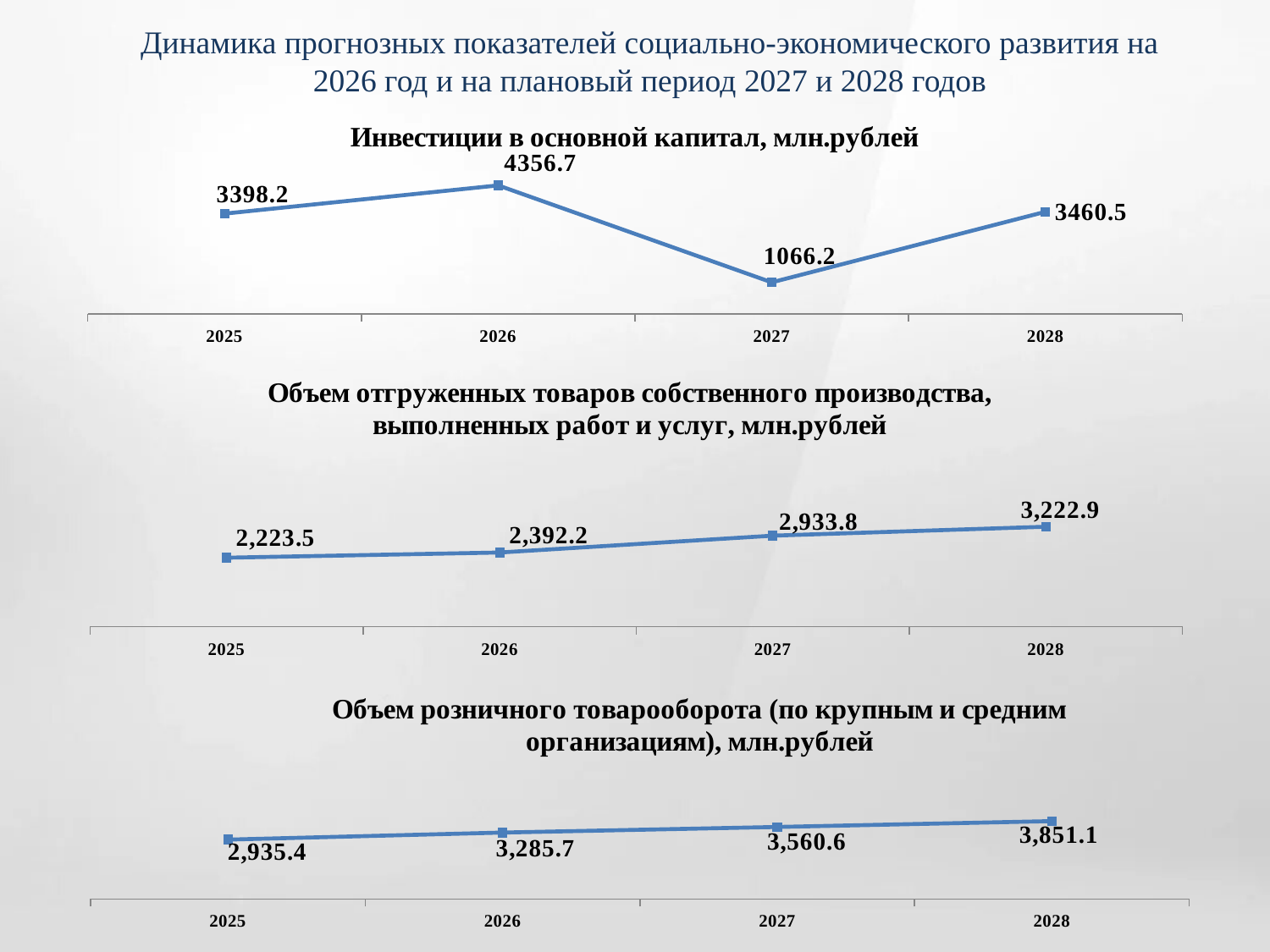
In the chart 'Объем отгруженных товаров собственного производства, выполненных работ и услуг, млн.рублей', what is the value for 2026? 2,392.2 In the chart 'Объем отгруженных товаров собственного производства, выполненных работ и услуг, млн.рублей', do the values rise or fall from 2025 to 2028? rise In the chart 'Инвестиции в основной капитал, млн.рублей', which year has the highest value? 2026 In the chart 'Объем розничного товарооборота (по крупным и средним организациям), млн.рублей', how many years are plotted? 4 What kind of chart is the top chart 'Инвестиции в основной капитал, млн.рублей'? line chart In the chart 'Инвестиции в основной капитал, млн.рублей', what is the value for 2027? 1066.2 In the chart 'Инвестиции в основной капитал, млн.рублей', which year has the lowest value? 2027 In the chart 'Инвестиции в основной капитал, млн.рублей', what is the difference between the 2026 and 2027 values? 3290.5 In the chart 'Объем розничного товарооборота (по крупным и средним организациям), млн.рублей', what is the value for 2028? 3,851.1 In the chart 'Объем розничного товарооборота (по крупным и средним организациям), млн.рублей', which is larger, the value for 2025 or the value for 2027? 2027 How many charts are shown on the slide? 3 In the chart 'Объем отгруженных товаров собственного производства, выполненных работ и услуг, млн.рублей', what is the difference between the 2028 and 2025 values? 999.4